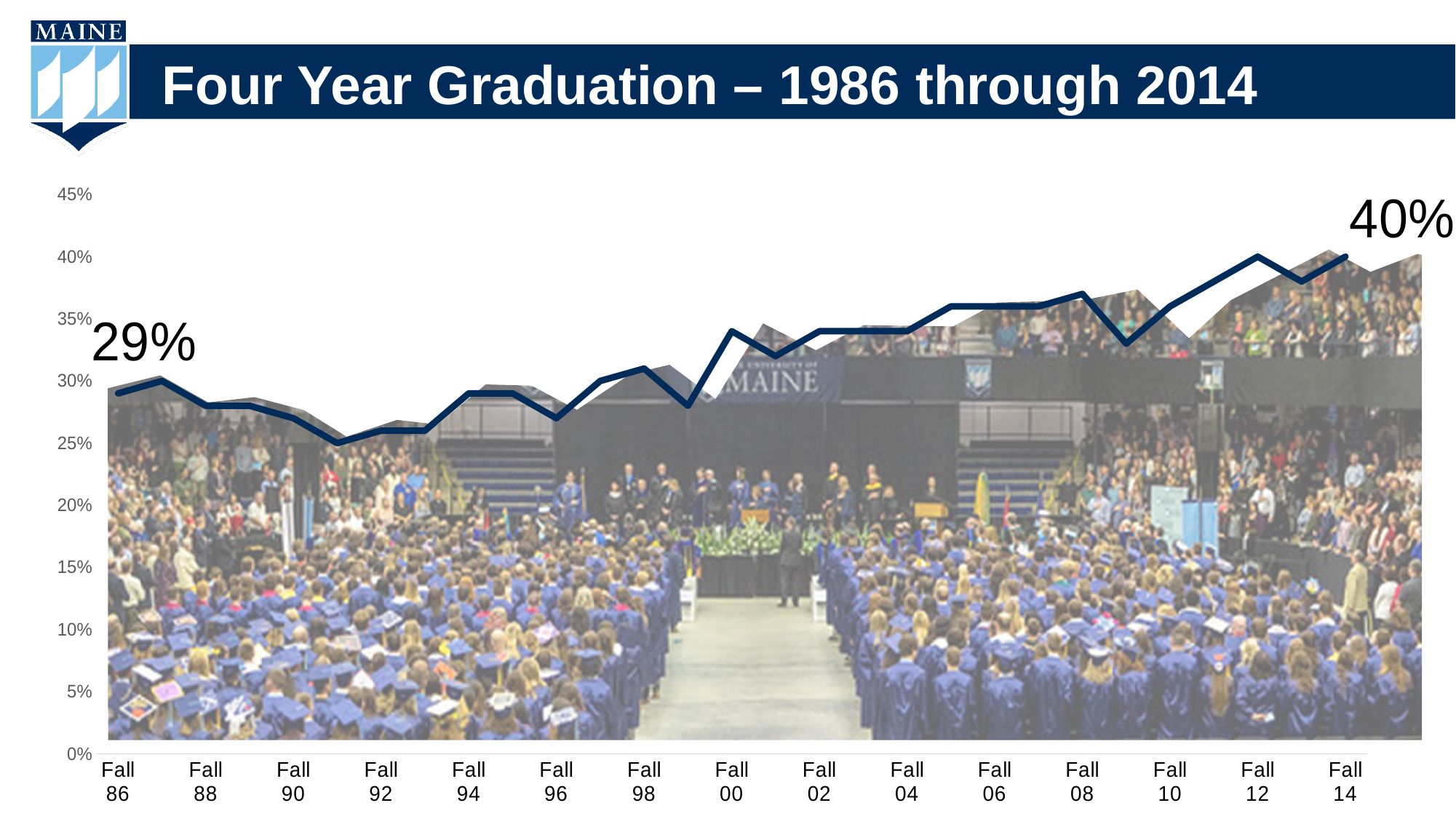
Overall, does the four-year graduation rate rise or fall from Fall 86 to Fall 14? rise How many labels are shown on the x axis of the chart? 15 What is the four-year graduation rate shown for Fall 14? 40% Is the value for Fall 00 greater or less than 30%? greater Which has the higher four-year graduation rate, Fall 86 or Fall 14? Fall 14 What is the four-year graduation rate shown for Fall 86? 29% By how many percentage points did the four-year graduation rate change from Fall 86 to Fall 14? 11 percentage points Is the value for Fall 92 greater or less than 30%? less Is the value for Fall 10 greater or less than 30%? greater What kind of chart is shown on the slide? line chart What is the title of the slide? Four Year Graduation – 1986 through 2014